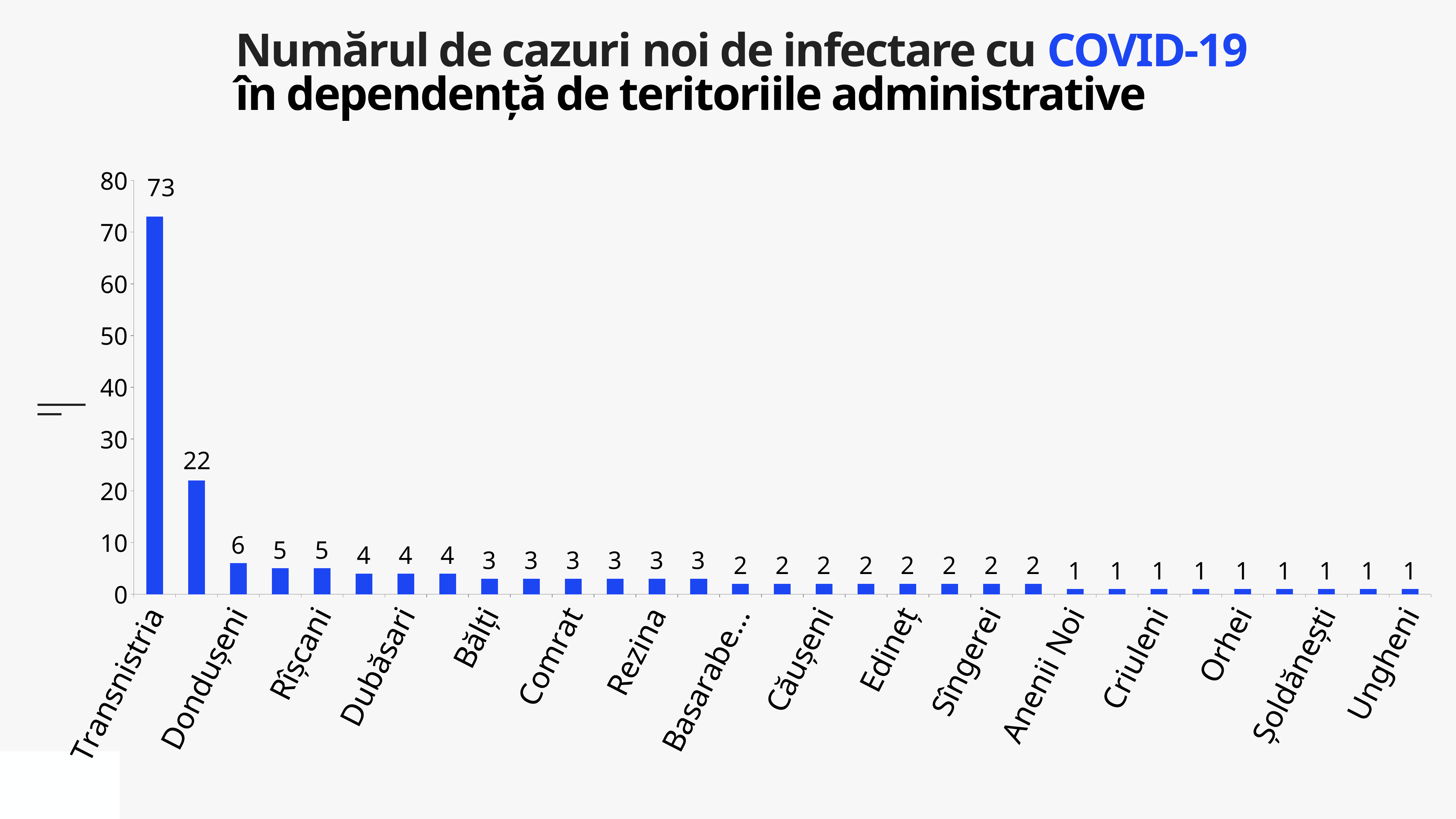
What colour are the bars in the chart? blue Do the values rise or fall from left to right along the x axis? fall Which territory has the highest number of new COVID-19 cases? Transnistria What is the difference between the values for Transnistria and Dondușeni? 67 How many bars are plotted in the chart? 31 How many new cases are shown for Rîșcani? 5 How many new cases are shown for Ungheni? 1 What kind of chart is shown on the slide? bar chart How many new cases are shown for Dondușeni? 6 How many new cases are shown for Transnistria? 73 Which has the larger value, Dubăsari or Bălți? Dubăsari Is the value for Transnistria greater or less than 70? greater